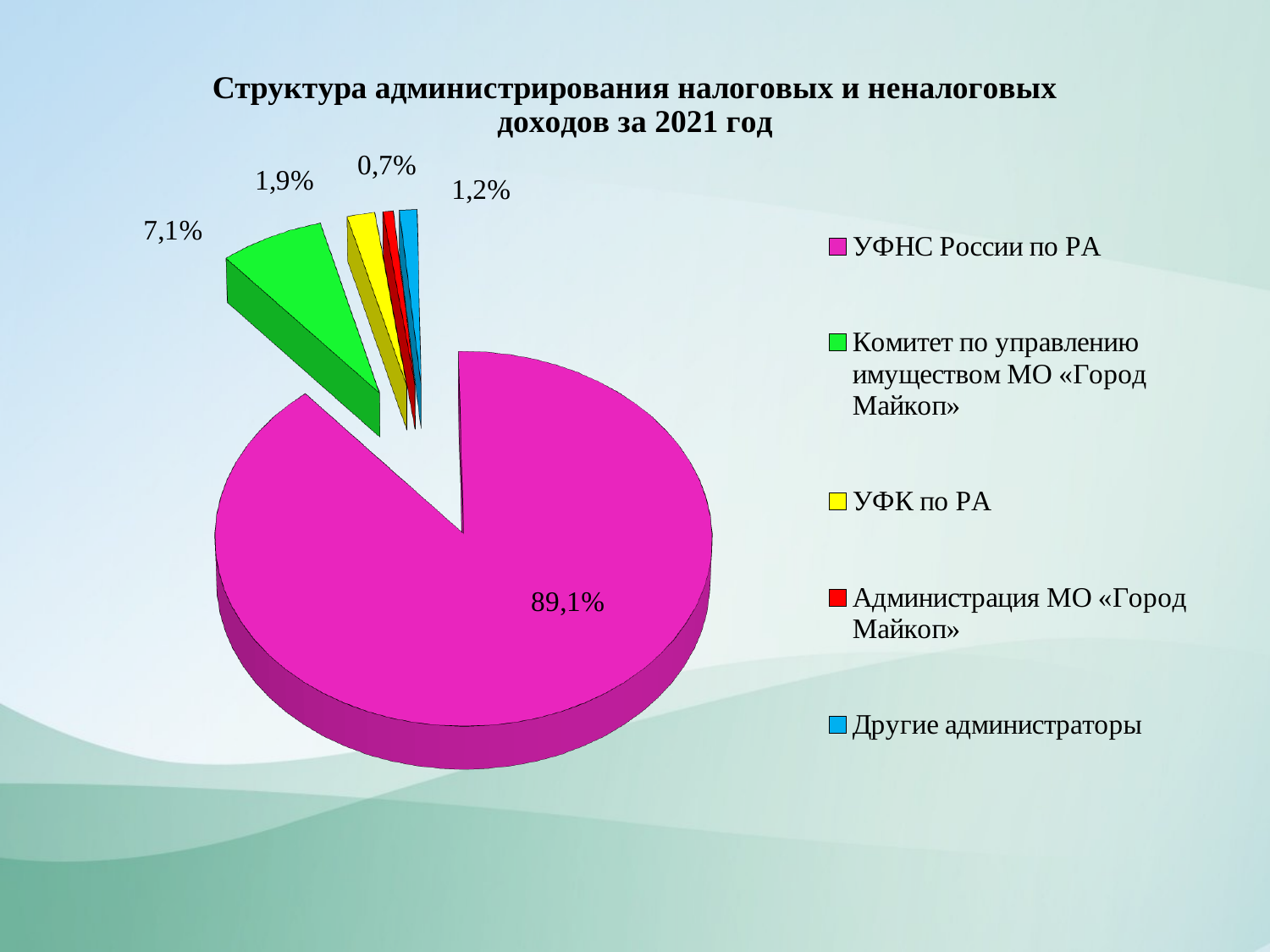
What is the value shown for Другие администраторы? 1,2% What is the value shown for Администрация МО «Город Майкоп»? 0,7% How many categories does the pie chart show? 5 Which is larger: the share of УФК по РА or the share of Другие администраторы? УФК по РА What is the title of the chart? Структура администрирования налоговых и неналоговых доходов за 2021 год Which category has the smallest slice of the pie? Администрация МО «Город Майкоп» What is the value shown for УФК по РА? 1,9% What is the difference between the shares of УФНС России по РА and Комитет по управлению имуществом МО «Город Майкоп»? 82,0% What share of the pie does УФНС России по РА hold? 89,1% Which category has the largest slice of the pie? УФНС России по РА What kind of chart is shown on the slide? Pie chart What is the value shown for Комитет по управлению имуществом МО «Город Майкоп»? 7,1%